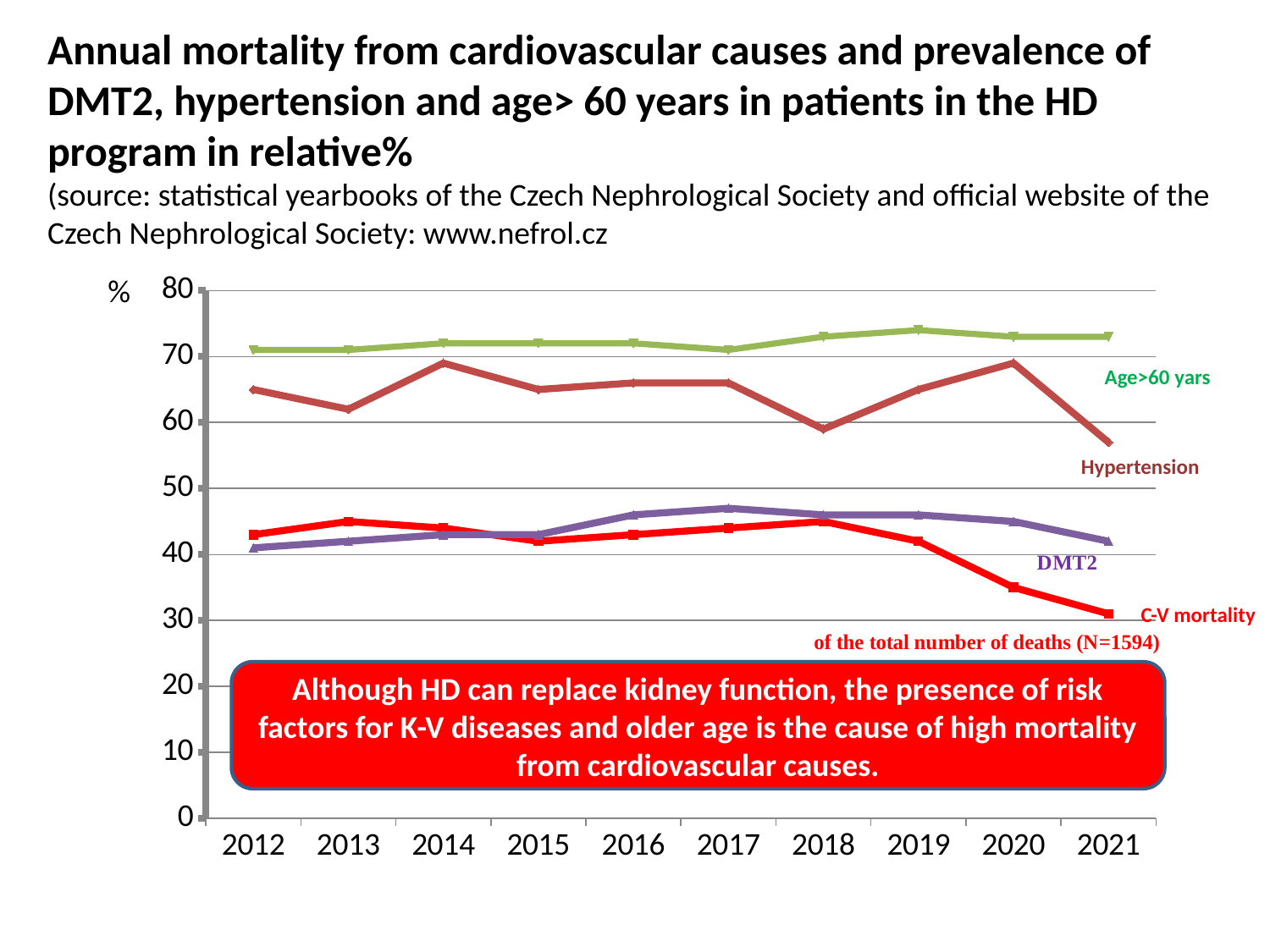
Is the value for Age>60 yars in 2019 greater or less than 70? greater Is the value for DMT2 in 2017 greater or less than 50? less Does C-V mortality rise or fall from 2018 to 2021? fall What kind of chart is shown on the slide? line chart Which series has the highest values across all years on the chart? Age>60 yars How many years are plotted along the x axis of the chart? 10 In 2020, which is larger: DMT2 or C-V mortality? DMT2 Is the value for C-V mortality in 2020 greater or less than 40? less In which year is C-V mortality at its lowest? 2021 What colour is the C-V mortality line on the chart? red How many data series are labelled on the chart? 4